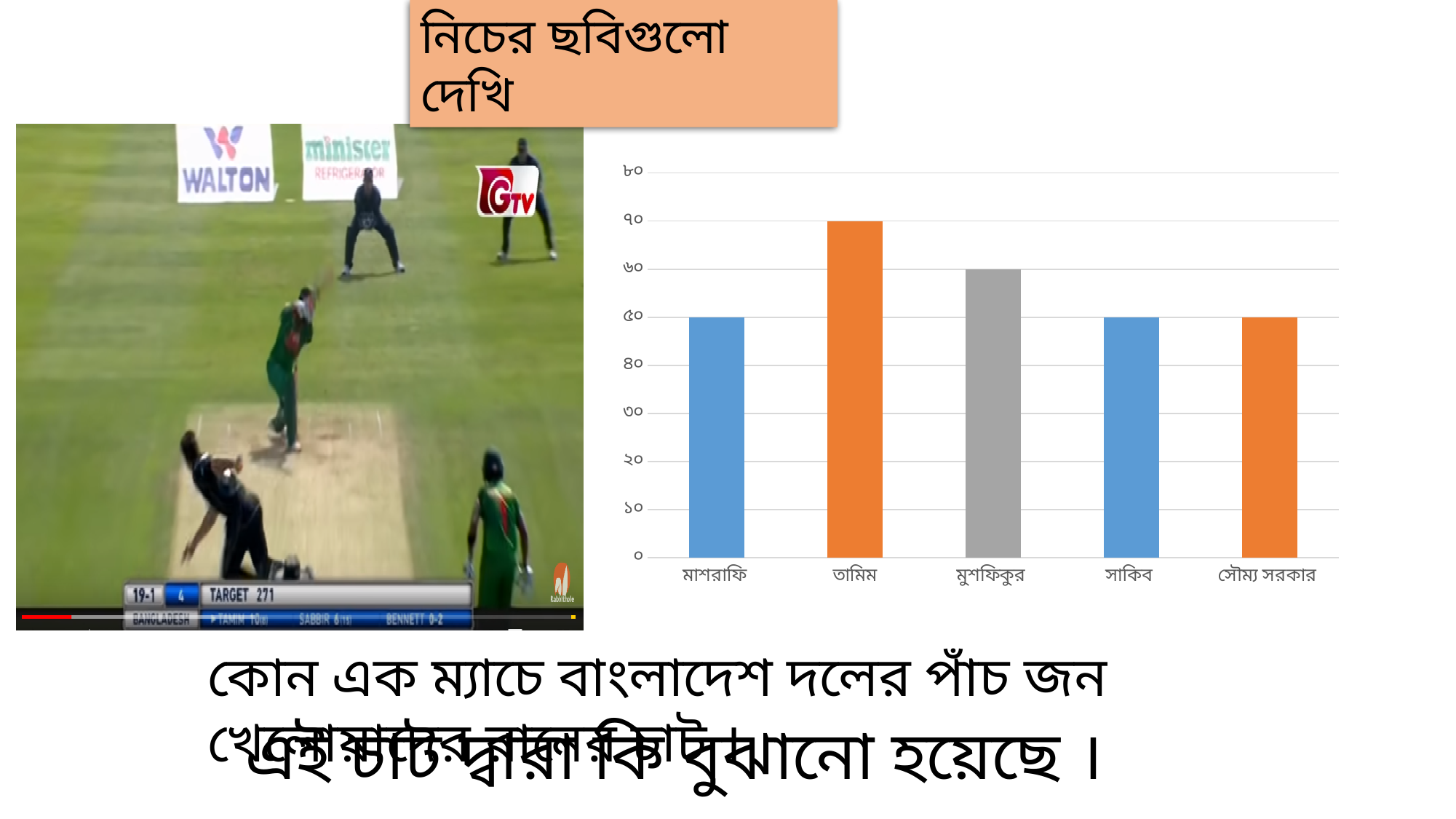
What is the value of the bar for মুশফিকুর? ৬০ How many players (categories) are shown on the x axis of the chart? 5 What is the value of the bar for সৌম্য সরকার? ৫০ What is the difference between the values for তামিম and সাকিব? ২০ What is the value of the bar for মাশরাফি? ৫০ What type of chart is shown on the slide? bar chart What colour is the bar for মুশফিকুর? grey Which is larger, the value for মুশফিকুর or the value for সাকিব? মুশফিকুর Which player has the highest bar in the chart? তামিম What is the difference between the values for তামিম and মুশফিকুর? ১০ What is the value of the bar for তামিম? ৭০ Is the value for মুশফিকুর greater or less than ৫০? greater